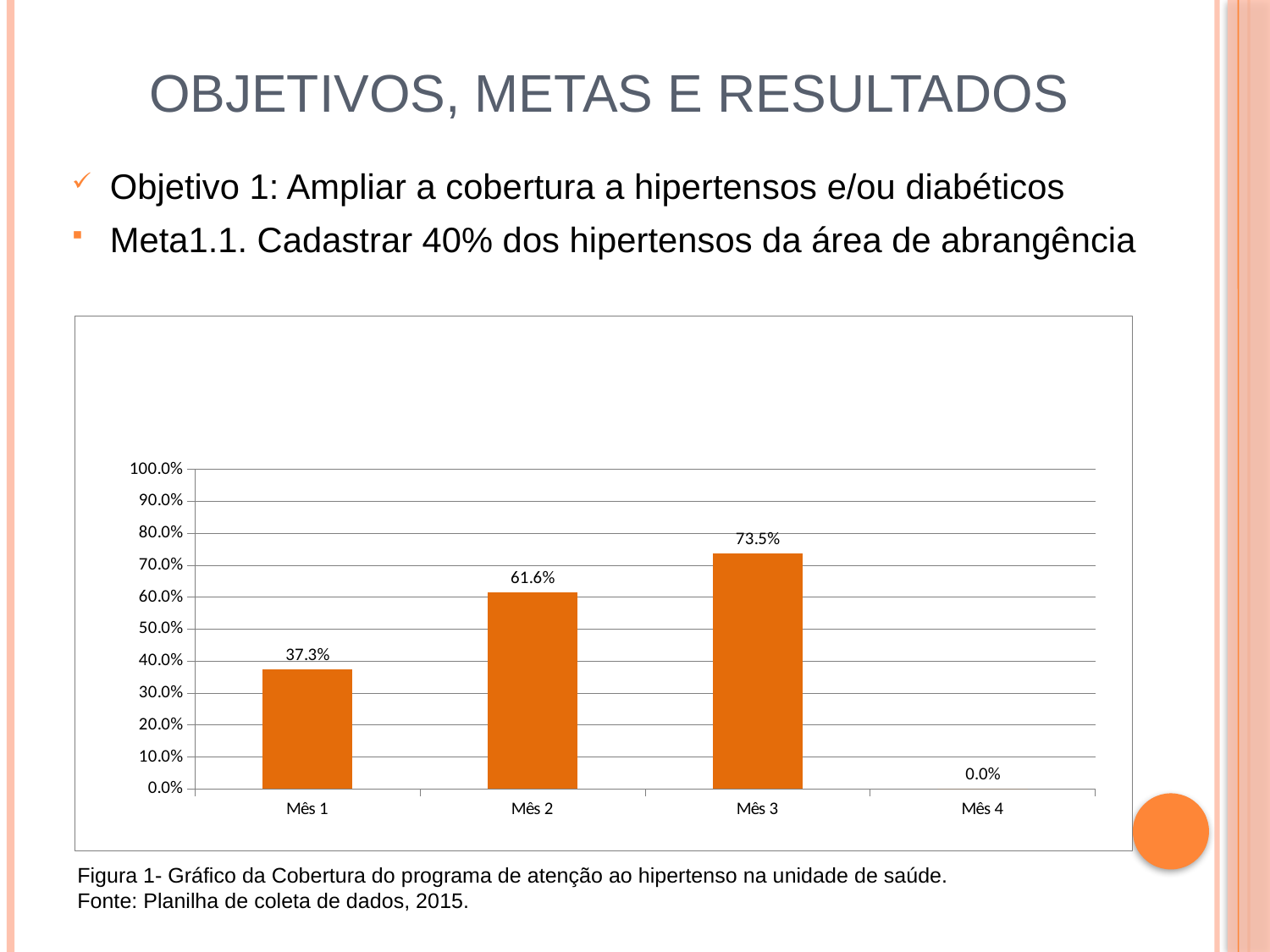
What kind of chart is shown on the slide? bar chart Is the value for Mês 1 greater or less than 40.0%? less What is the value for Mês 4? 0.0% Which month has the highest value? Mês 3 Which is larger, the value for Mês 1 or the value for Mês 2? Mês 2 What is the difference between the values for Mês 2 and Mês 1? 24.3% What is the value for Mês 2? 61.6% What is the value for Mês 1? 37.3% What is the difference between the values for Mês 3 and Mês 2? 11.9% What is the value for Mês 3? 73.5% How many months are shown on the x axis? 4 Which month has the lowest value? Mês 4